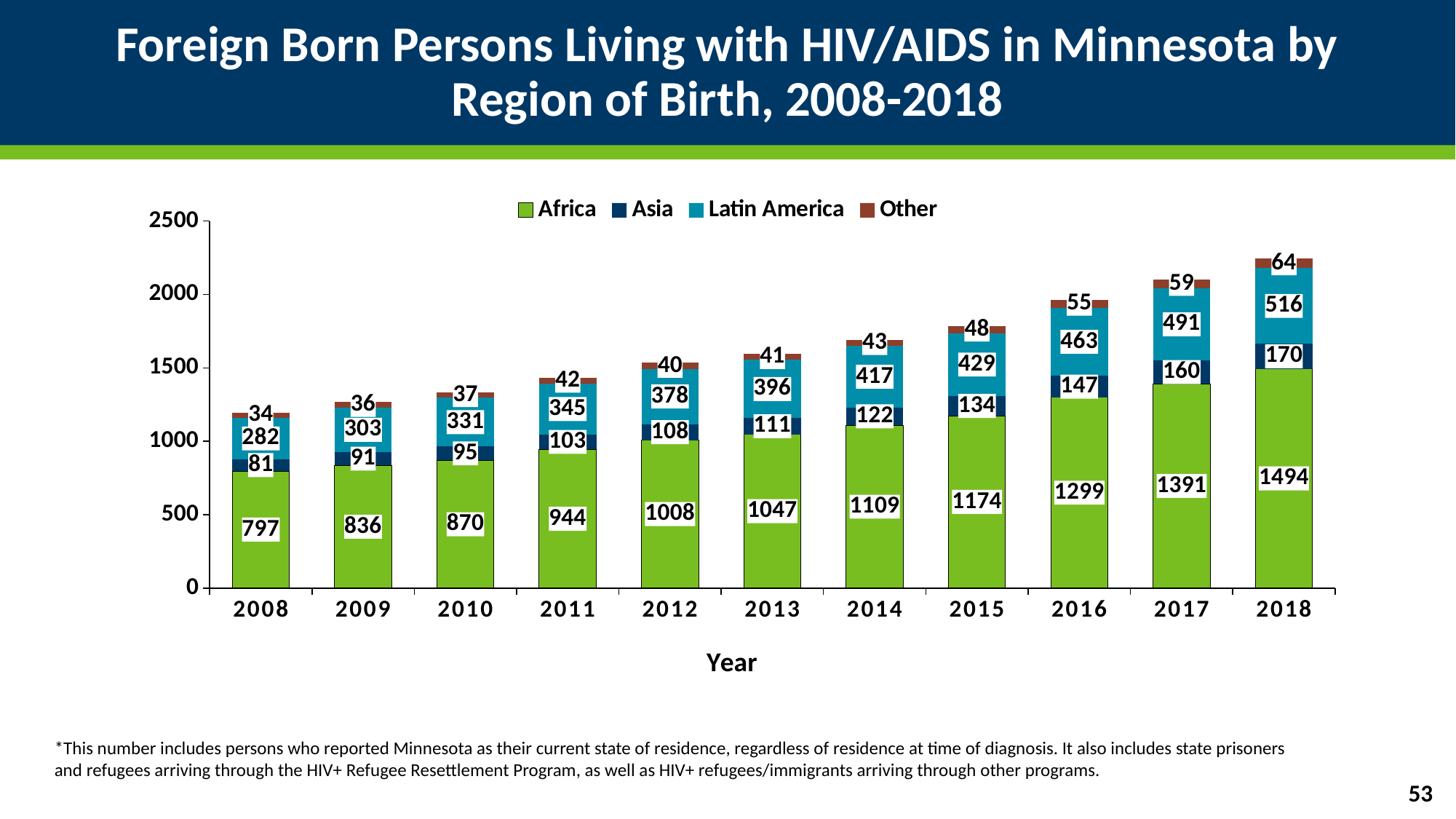
Which year has the highest value for Africa? 2018 Which year has the lowest value for Latin America? 2008 How many series does the legend list? 4 What is the value for Africa in 2018? 1494 What is the total of the stacked bar for 2008? 1194 What is the value for Latin America in 2012? 378 How many years are shown on the x axis? 11 What is the difference between the Africa values for 2018 and 2008? 697 What is the value for Other in 2010? 37 What is the value for Asia in 2015? 134 Do the Africa values rise or fall from 2008 to 2018? rise Which is larger, the Asia value in 2017 or the Asia value in 2014? 2017